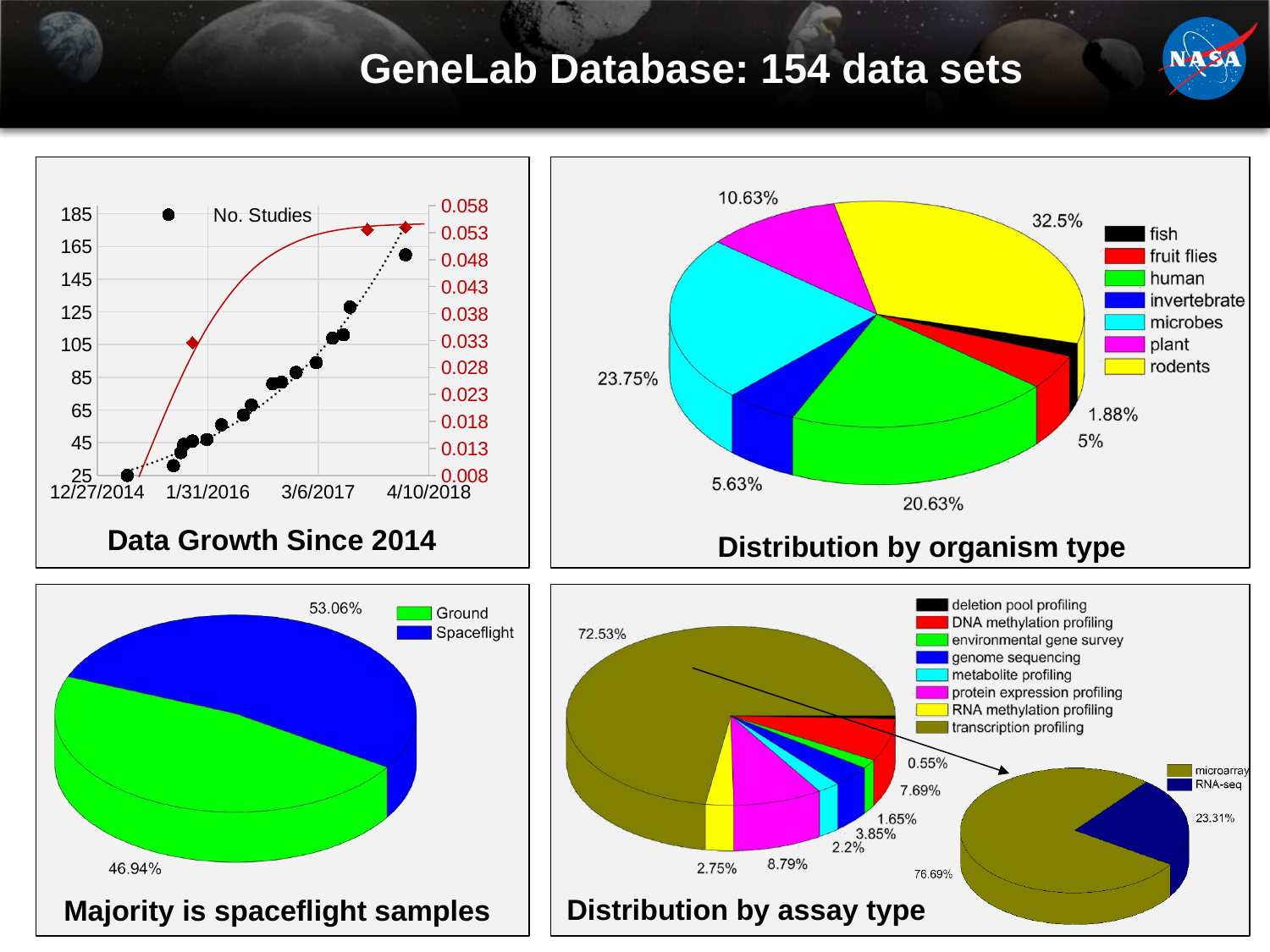
In the 'Distribution by organism type' pie chart, which organism type has the largest share? rodents In the 'Majority is spaceflight samples' pie chart, what share is shown for Spaceflight? 53.06% In the 'Distribution by organism type' pie chart, which organism type has the smallest share? fish In the 'Distribution by organism type' pie chart, what is the difference between the rodents share and the microbes share? 8.75% What kind of chart is 'Majority is spaceflight samples'? pie chart How many organism types does the legend of the 'Distribution by organism type' pie chart list? 7 In the 'Distribution by organism type' pie chart, what share is shown for rodents? 32.5% In the 'Majority is spaceflight samples' pie chart, what is the difference between the Spaceflight share and the Ground share? 6.12% In the 'Data Growth Since 2014' chart, does the number of studies rise or fall over time? rise In the 'Distribution by assay type' pie chart, what share is shown for transcription profiling? 72.53% In the 'Distribution by organism type' pie chart, which has the larger share, microbes or human? microbes How many assay types does the legend of the 'Distribution by assay type' pie chart list? 8